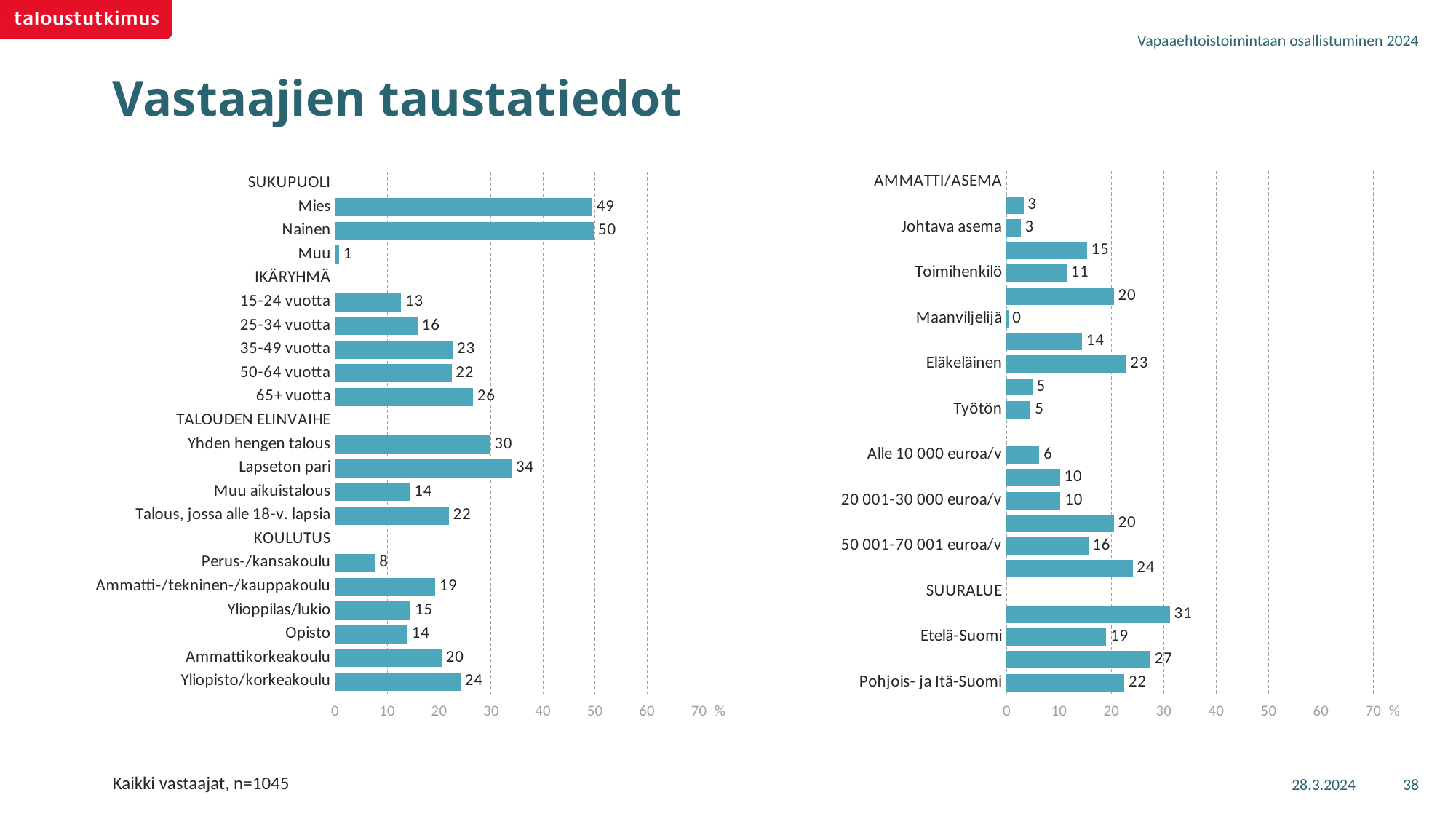
In the left chart, what is the value for Nainen? 50 In the left chart, which is larger, Ammattikorkeakoulu or Ylioppilas/lukio? Ammattikorkeakoulu In the left chart, what is the difference between Yliopisto/korkeakoulu and Perus-/kansakoulu? 16 What type of chart is shown on the left side of the slide? Bar chart In the left chart, which age group (IKÄRYHMÄ) has the lowest value? 15-24 vuotta In the right chart, what is the value for Eläkeläinen? 23 In the right chart, which is larger, Etelä-Suomi or Pohjois- ja Itä-Suomi? Pohjois- ja Itä-Suomi In the right chart, what is the value for Maanviljelijä? 0 In the left chart, which TALOUDEN ELINVAIHE category has the highest value? Lapseton pari In the right chart, what is the value for 50 001-70 001 euroa/v? 16 In the right chart, what is the difference between Toimihenkilö and Työtön? 6 In the left chart, what is the value for 65+ vuotta? 26